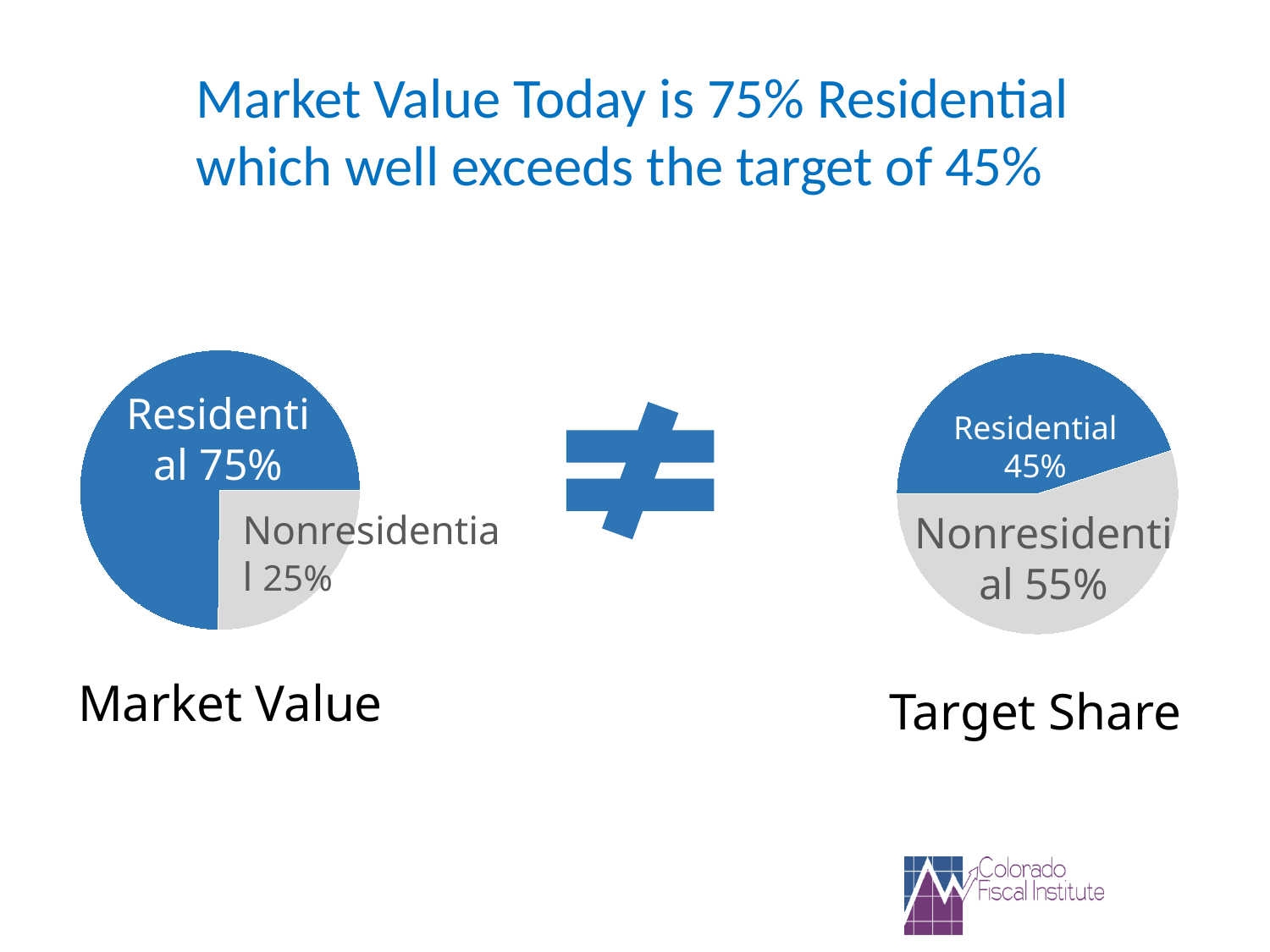
How many slices does the Market Value pie chart have? 2 In the Target Share pie chart, which slice is the smallest? Residential In the Market Value pie chart, which slice is the largest? Residential In the Market Value pie chart, what share is Residential? 75% In the Market Value pie chart, what share is Nonresidential? 25% In the Target Share pie chart, what is the difference between the Nonresidential and Residential shares? 10% In the Target Share pie chart, what share is Residential? 45% What type of chart is the Target Share chart? Pie chart Is the Residential share larger in the Market Value chart or the Target Share chart? Market Value In the Target Share pie chart, what share is Nonresidential? 55% What colour is the Residential slice in the Market Value pie chart? Blue In the Market Value pie chart, what is the difference between the Residential and Nonresidential shares? 50%